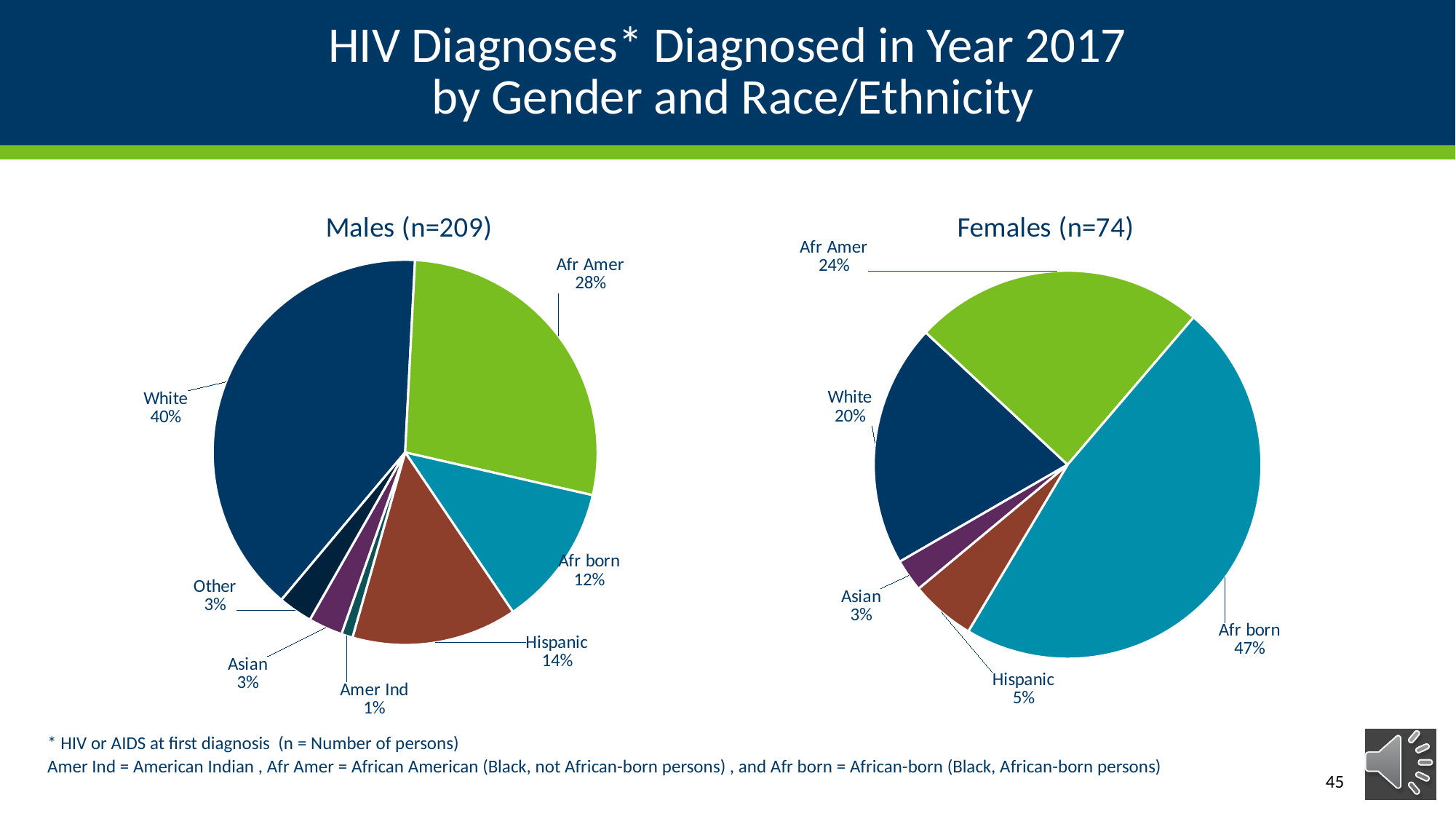
In the Females (n=74) pie chart, which is larger, the Afr Amer share or the White share? Afr Amer In the Females (n=74) pie chart, what share of diagnoses is Afr born? 47% In the Males (n=209) pie chart, what is the difference between the Afr Amer share and the Hispanic share? 14% What type of chart is used for the Females (n=74) data? Pie chart How many categories are shown in the Males (n=209) pie chart? 7 In the Males (n=209) pie chart, what share of diagnoses is White? 40% In the Females (n=74) pie chart, which category has the largest share? Afr born In the Males (n=209) pie chart, which category has the largest share? White In the Males (n=209) pie chart, which category has the smallest share? Amer Ind In the Females (n=74) pie chart, which category has the smallest share? Asian How many categories are shown in the Females (n=74) pie chart? 5 In the Males (n=209) pie chart, what share of diagnoses is Hispanic? 14%